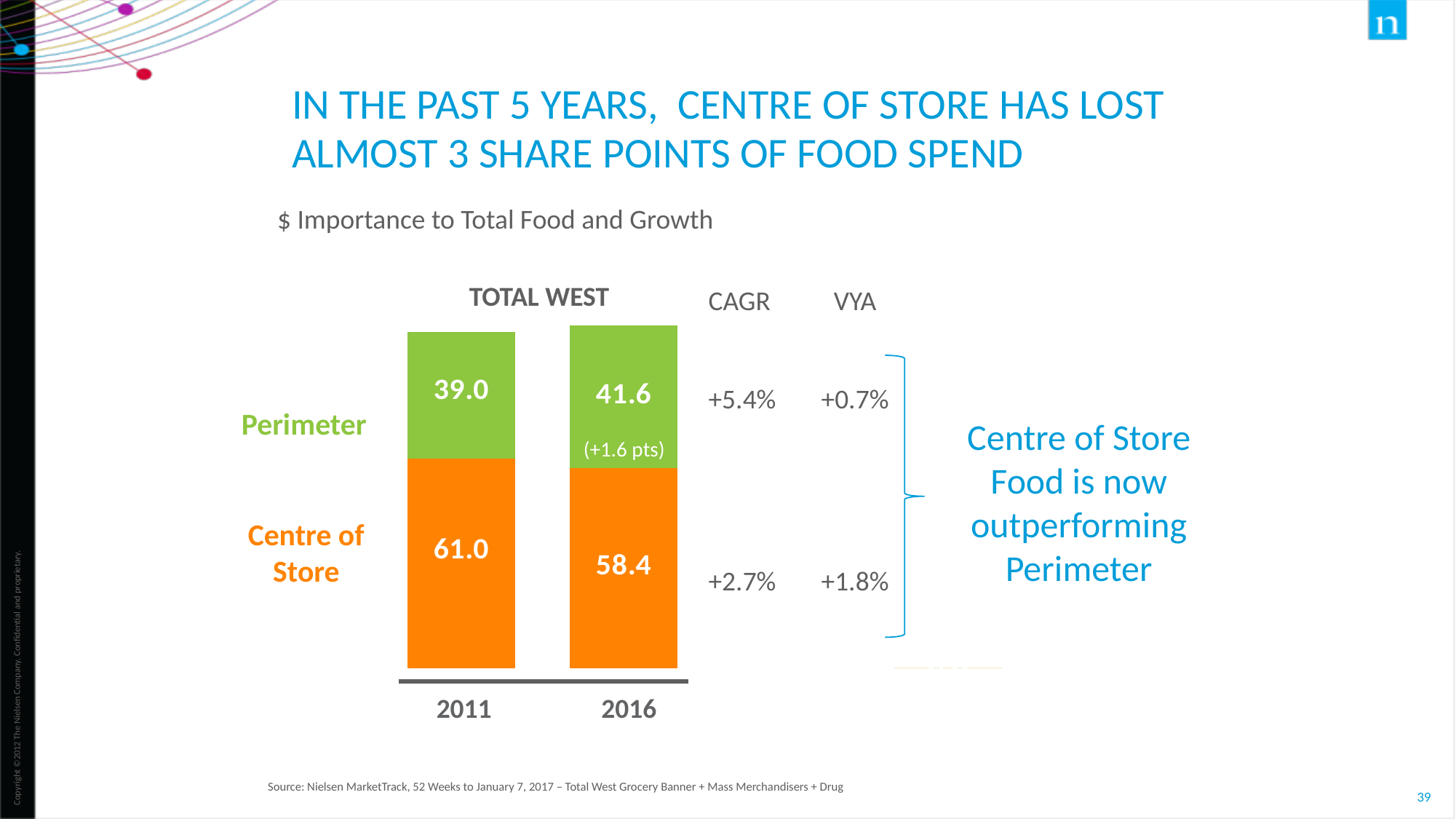
What colour represents Centre of Store in the chart? Orange What is the Centre of Store value for 2016? 58.4 How many series are shown in the stacked bars? 2 What is the Perimeter value for 2016? 41.6 What kind of chart is shown on the slide? Stacked bar chart Does the Perimeter value rise or fall from 2011 to 2016? Rise What is the Perimeter value for 2011? 39.0 What is the total of the stacked bar for 2011? 100.0 What is the Centre of Store value for 2011? 61.0 How many years are shown on the x axis? 2 Which is larger in 2016, Perimeter or Centre of Store? Centre of Store By how much did the Centre of Store value fall from 2011 to 2016? 2.6